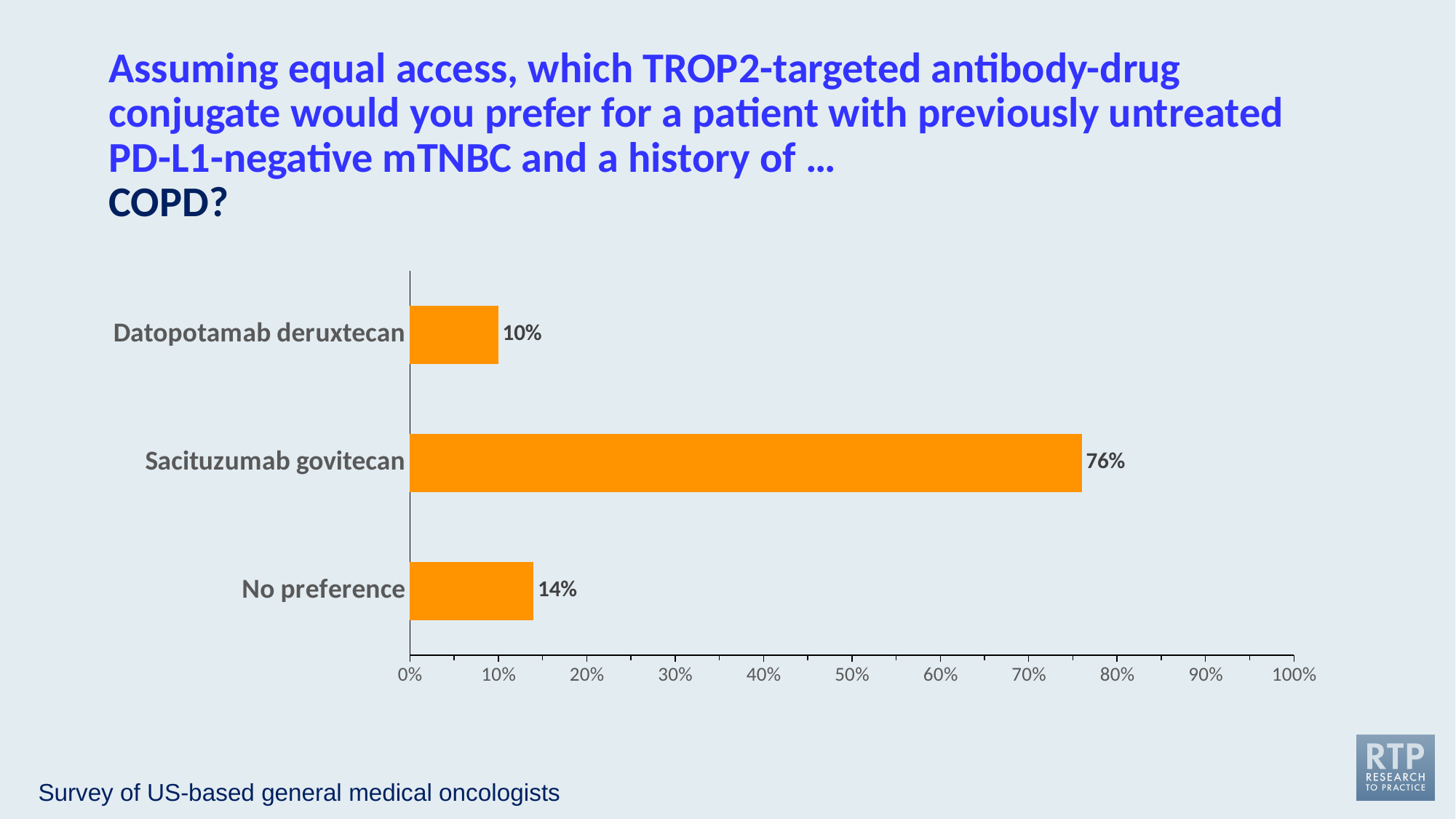
What percentage of respondents indicated no preference? 14% Which response option has the highest percentage? Sacituzumab govitecan What percentage of respondents preferred datopotamab deruxtecan? 10% How many response categories are shown in the chart? 3 What is the difference in percentage points between no preference and datopotamab deruxtecan? 4 What percentage of respondents preferred sacituzumab govitecan? 76% Is the value for sacituzumab govitecan greater or less than 70%? greater Which response option has the lowest percentage? Datopotamab deruxtecan What type of chart is shown on the slide? Bar chart Which has a larger share, no preference or datopotamab deruxtecan? No preference What is the difference in percentage points between sacituzumab govitecan and datopotamab deruxtecan? 66 What is the maximum value shown on the x axis? 100%